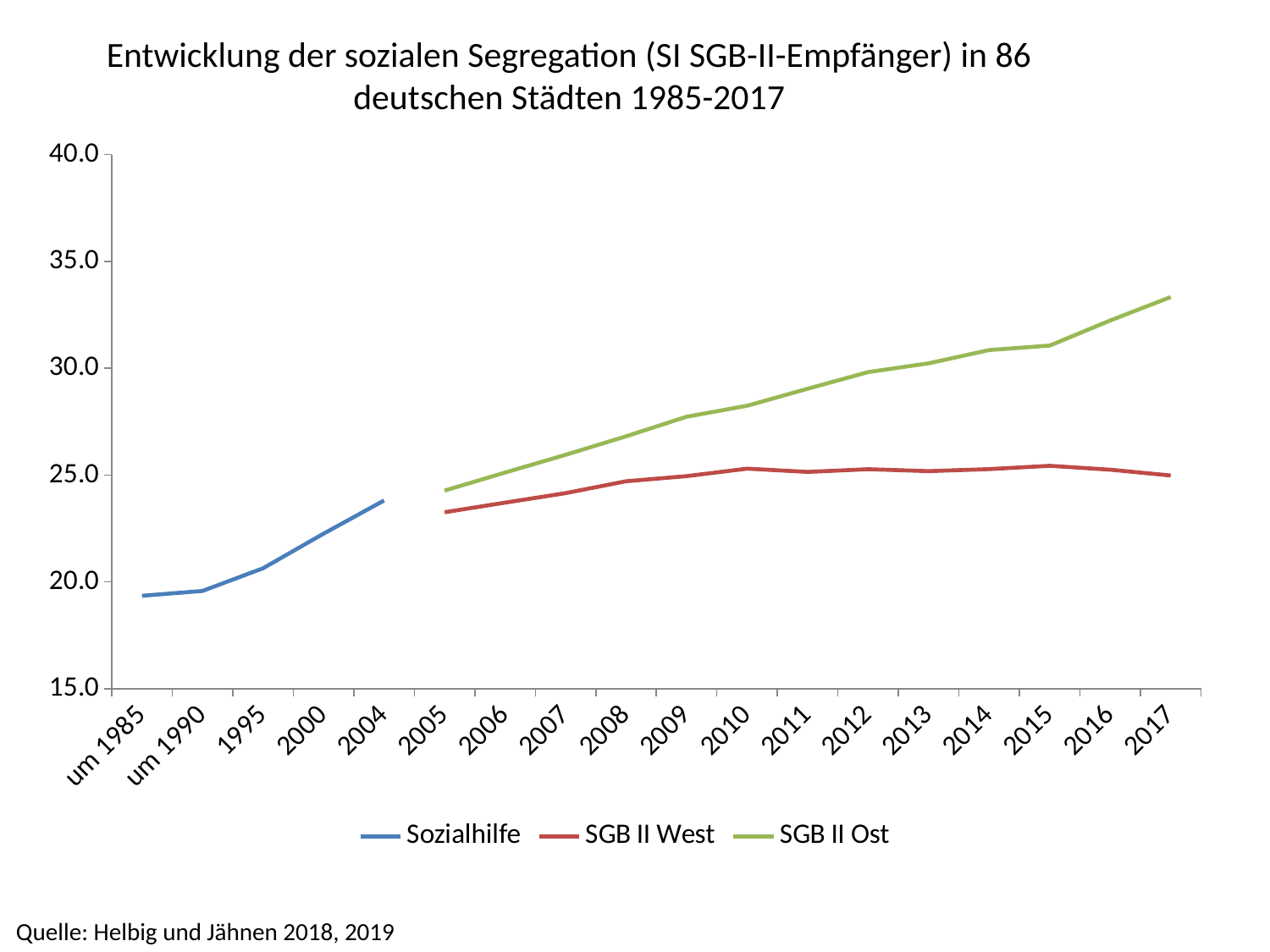
Is the value for SGB II West in 2017 greater or less than 30.0? less In 2017, which series has the higher value, SGB II West or SGB II Ost? SGB II Ost How many series does the legend list? 3 Which series reaches the highest value on the chart? SGB II Ost Is the value for SGB II Ost in 2017 greater or less than 30.0? greater Is the value for SGB II Ost in 2005 greater or less than 25.0? less How many points are labelled on the x axis? 18 Does the SGB II Ost line rise or fall from 2005 to 2017? rise Which series does the legend list in green? SGB II Ost What kind of chart is shown on the slide? line chart